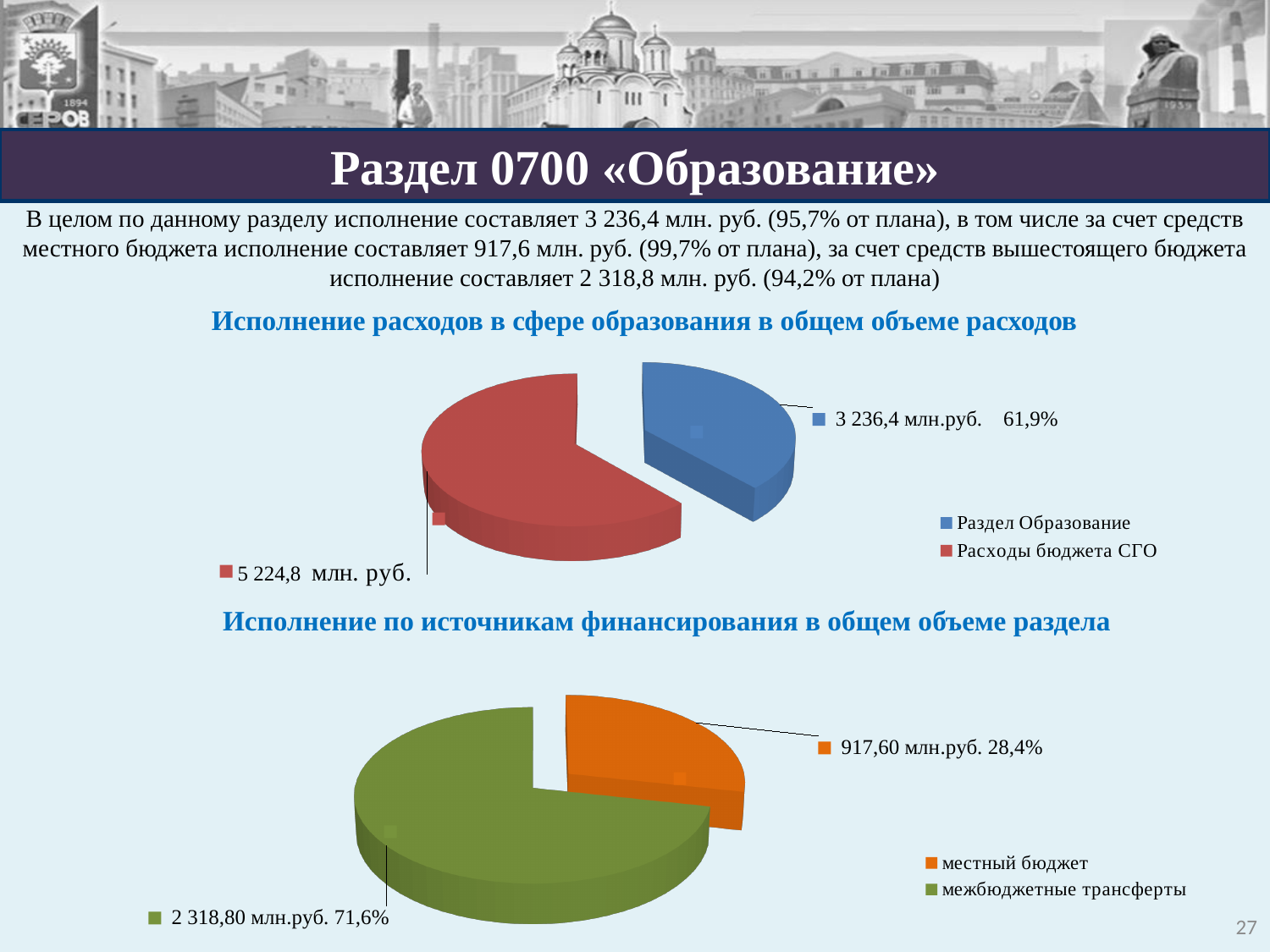
On the chart titled «Исполнение по источникам финансирования в общем объеме раздела», what value is shown for «межбюджетные трансферты»? 2 318,80 млн.руб. On the chart titled «Исполнение расходов в сфере образования в общем объеме расходов», what value is shown for «Расходы бюджета СГО»? 5 224,8 млн. руб. On the chart titled «Исполнение расходов в сфере образования в общем объеме расходов», what is the difference between the «Расходы бюджета СГО» value and the «Раздел Образование» value? 1 988,4 млн. руб. What type of chart is the lower chart titled «Исполнение по источникам финансирования в общем объеме раздела»? Pie chart On the chart titled «Исполнение расходов в сфере образования в общем объеме расходов», what percentage is printed next to the «Раздел Образование» slice? 61,9% On the chart titled «Исполнение по источникам финансирования в общем объеме раздела», which source is the largest? межбюджетные трансферты On the chart titled «Исполнение по источникам финансирования в общем объеме раздела», what share of the pie is «межбюджетные трансферты»? 71,6% On the chart titled «Исполнение по источникам финансирования в общем объеме раздела», what value is shown for «местный бюджет»? 917,60 млн.руб. On the chart titled «Исполнение расходов в сфере образования в общем объеме расходов», what value is shown for «Раздел Образование»? 3 236,4 млн.руб. On the chart titled «Исполнение по источникам финансирования в общем объеме раздела», what share of the pie is «местный бюджет»? 28,4% On the chart titled «Исполнение по источникам финансирования в общем объеме раздела», what is the difference between «межбюджетные трансферты» and «местный бюджет»? 1 401,20 млн.руб. On the chart titled «Исполнение расходов в сфере образования в общем объеме расходов», which slice is larger: «Раздел Образование» or «Расходы бюджета СГО»? Расходы бюджета СГО